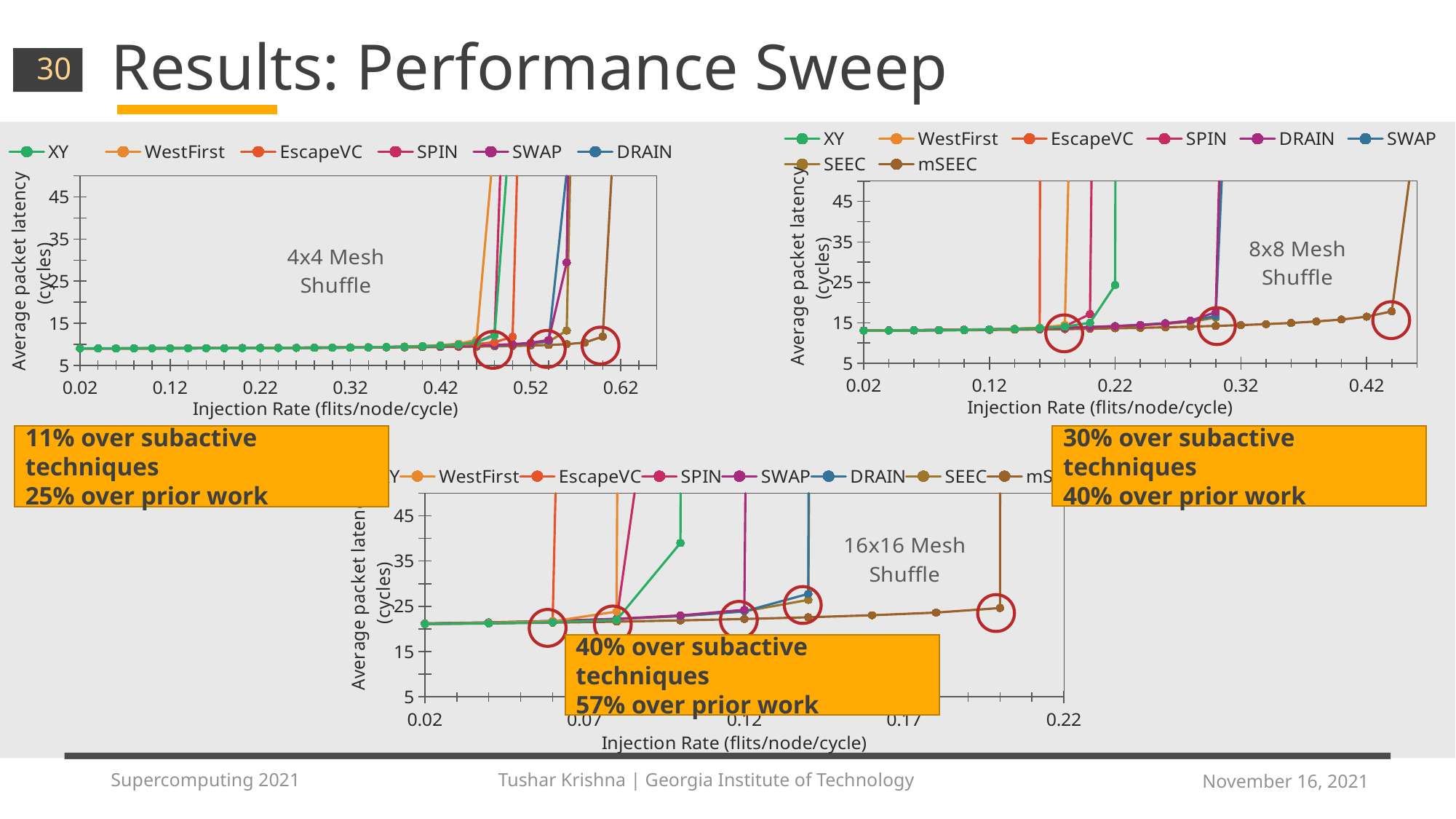
In the 8x8 Mesh Shuffle chart, is the average packet latency at injection rate 0.02 greater or less than 25? less In the 8x8 Mesh Shuffle chart, what is the label of the y axis? Average packet latency (cycles) In the 16x16 Mesh Shuffle chart, which series has its latency spike at the lowest injection rate? EscapeVC In the 4x4 Mesh Shuffle chart, does the average packet latency rise or fall as the injection rate increases? rise In the 16x16 Mesh Shuffle chart, is the average packet latency at injection rate 0.02 greater or less than 15? greater In the 16x16 Mesh Shuffle chart, is the average packet latency at injection rate 0.02 greater or less than 25? less What type of chart is the 4x4 Mesh Shuffle chart? line chart How many series does the legend of the 8x8 Mesh Shuffle chart list? 8 In the 8x8 Mesh Shuffle chart, which series sustains the highest injection rate before its latency spikes? mSEEC In the 4x4 Mesh Shuffle chart, which series has its latency spike at the lowest injection rate? WestFirst In the 16x16 Mesh Shuffle chart, what is the label of the x axis? Injection Rate (flits/node/cycle)